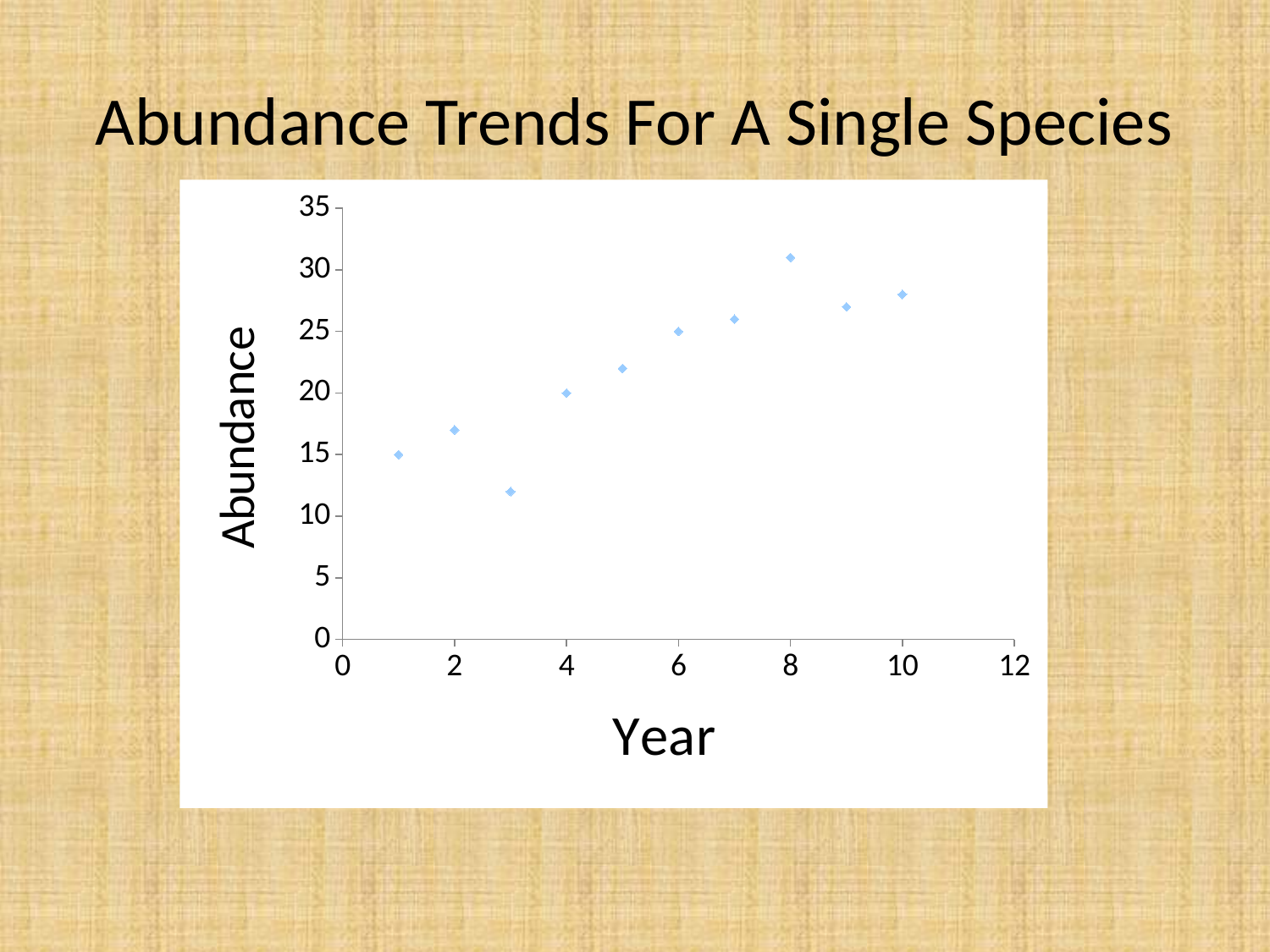
What kind of chart is shown on the slide? scatter chart What is the abundance in year 1? 15 What is the abundance in year 4? 20 In which year is abundance highest? 8 Is the abundance in year 8 greater or less than 30? greater Which year has the larger abundance, year 8 or year 10? 8 How many data points are plotted on the chart? 10 In which year is abundance lowest? 3 What is the label of the vertical axis? Abundance Is the abundance in year 3 greater or less than 15? less What is the title of the chart? Abundance Trends For A Single Species Overall, does abundance rise or fall as the year increases? rise